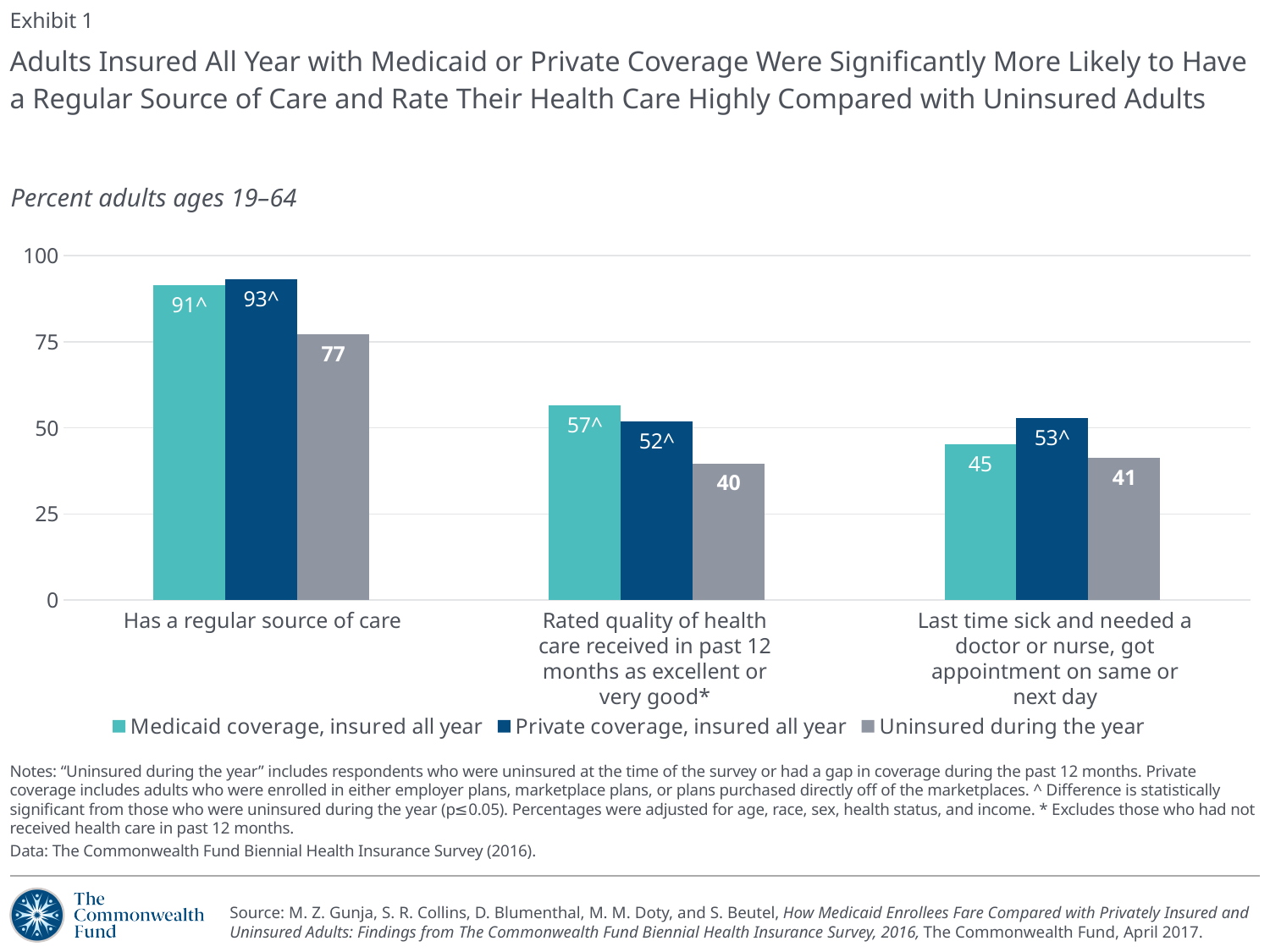
Which series has the lowest value in the 'Rated quality of health care received in past 12 months as excellent or very good' category? Uninsured during the year What is the value for 'Uninsured during the year' in the 'Has a regular source of care' category? 77 In the 'Last time sick and needed a doctor or nurse' category, which is larger: the 'Private coverage, insured all year' value or the 'Uninsured during the year' value? Private coverage, insured all year How many categories are shown on the x axis? 3 Which series has the highest value in the 'Has a regular source of care' category? Private coverage, insured all year How many series does the legend list? 3 What is the subtitle describing the unit of the chart's values? Percent adults ages 19–64 What is the value for 'Uninsured during the year' in the 'Rated quality of health care received in past 12 months as excellent or very good' category? 40 Is the value for 'Medicaid coverage, insured all year' in the 'Rated quality of health care' category greater or less than 50? greater What is the value for 'Medicaid coverage, insured all year' in the 'Last time sick and needed a doctor or nurse, got appointment on same or next day' category? 45 What is the difference between the 'Medicaid coverage, insured all year' value and the 'Uninsured during the year' value in the 'Has a regular source of care' category? 14 What type of chart is shown on the slide? Bar chart